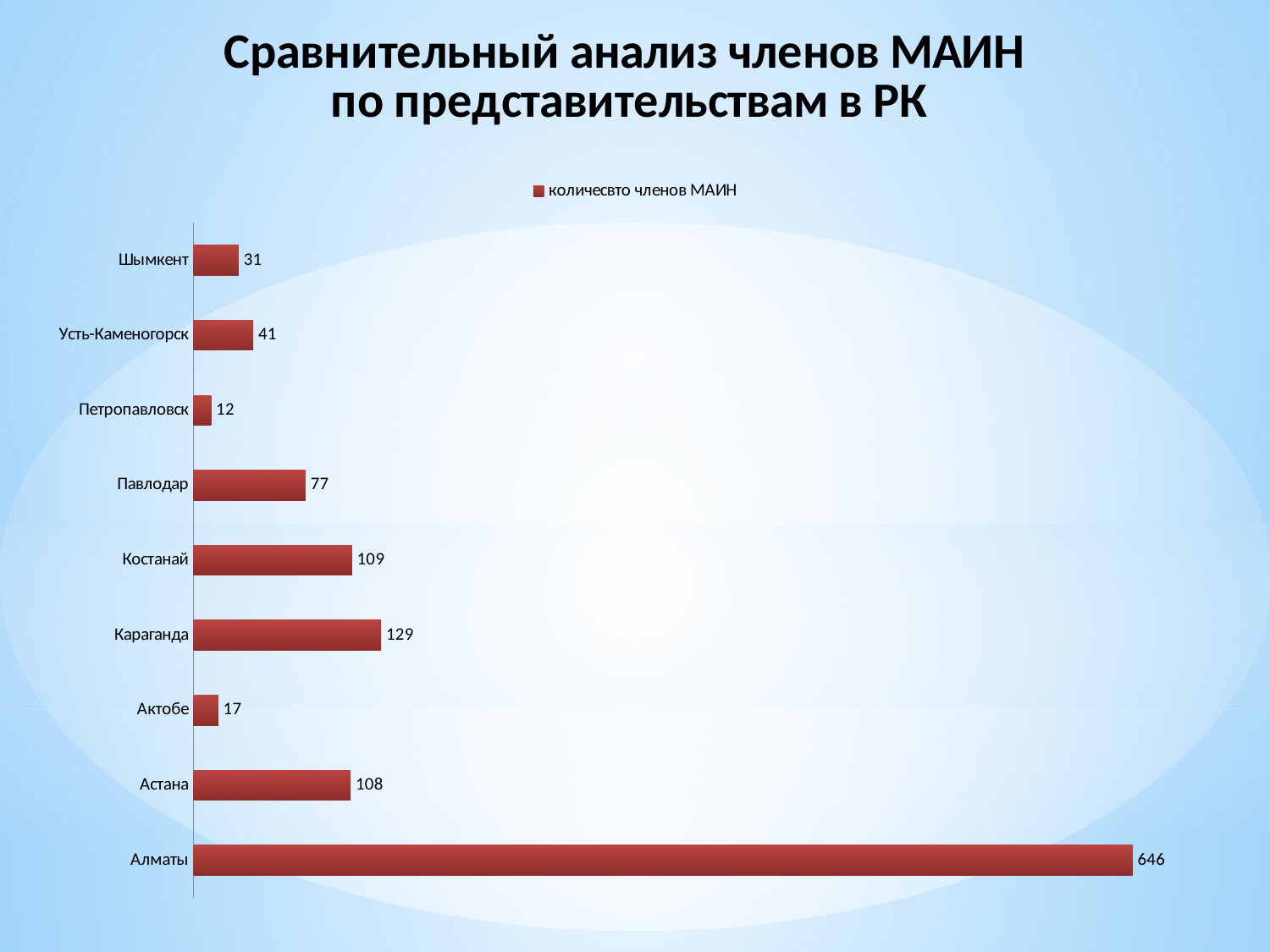
What is the value shown for Петропавловск? 12 What is the legend entry of the series shown in the chart? количесвто членов МАИН What is the difference between the values for Алматы and Караганда? 517 Which has a larger value, Усть-Каменогорск or Шымкент? Усть-Каменогорск What type of chart is shown on the slide? Bar chart How many cities are shown in the chart? 9 How many MAIN members does Алматы have according to the chart? 646 What is the value shown for Караганда? 129 Which city has the lowest number of MAIN members? Петропавловск Which city has the highest number of MAIN members? Алматы What is the difference between the values for Костанай and Астана? 1 Which has a larger value, Павлодар or Актобе? Павлодар